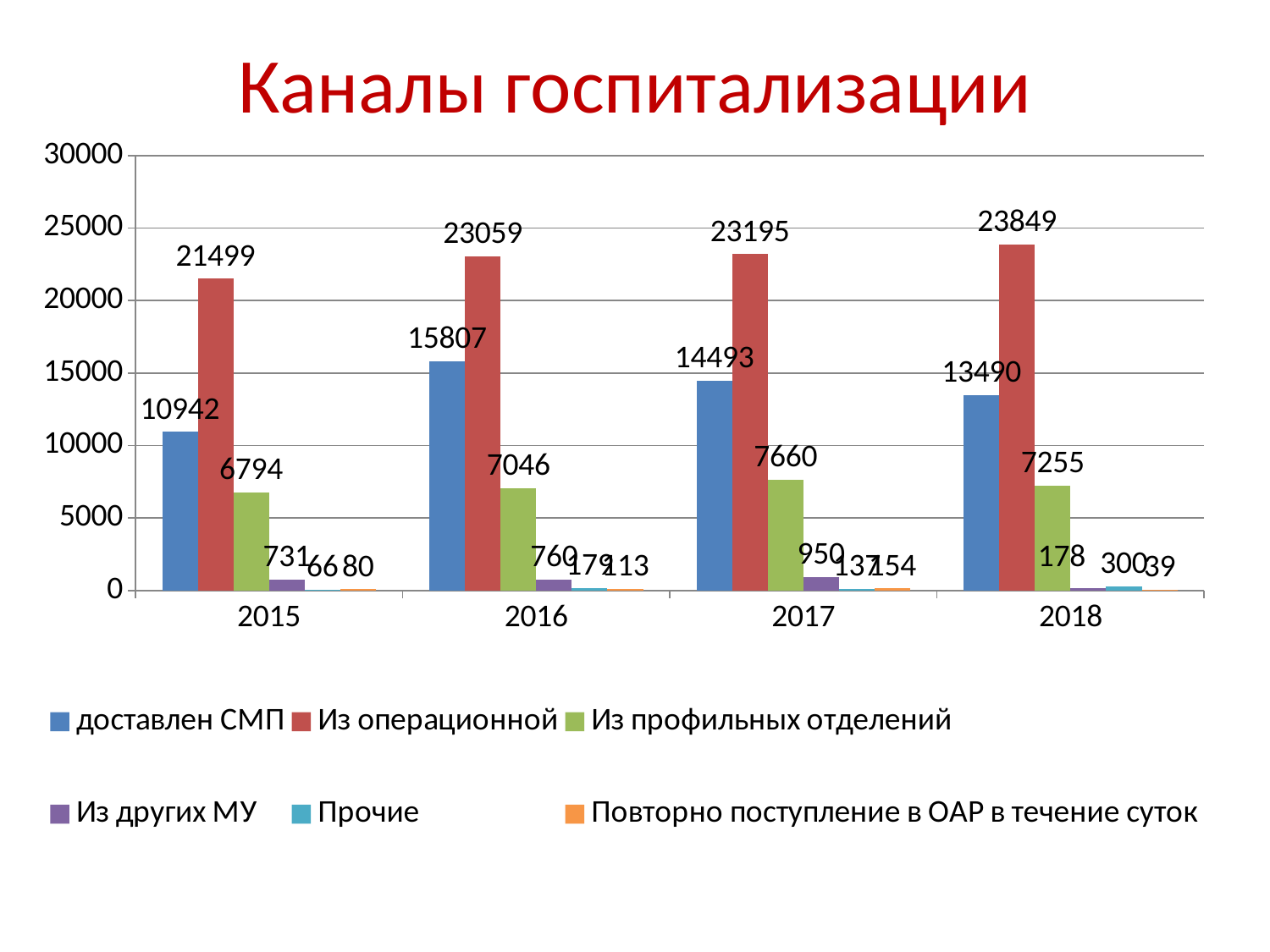
What kind of chart is shown on the slide? bar chart What is the value for "Из профильных отделений" in 2017? 7660 What is the value for "доставлен СМП" in 2016? 15807 What is the title of the chart? Каналы госпитализации What is the difference between the "Из операционной" values in 2016 and 2015? 1560 How many series does the legend list? 6 In which year is the value for "доставлен СМП" the lowest? 2015 Which is larger: "доставлен СМП" in 2017 or "доставлен СМП" in 2018? 2017 In which year is the value for "Из операционной" the highest? 2018 How many years are shown on the x axis? 4 What is the value for "Из операционной" in 2018? 23849 Does the value for "Из операционной" rise or fall from 2015 to 2018? rise